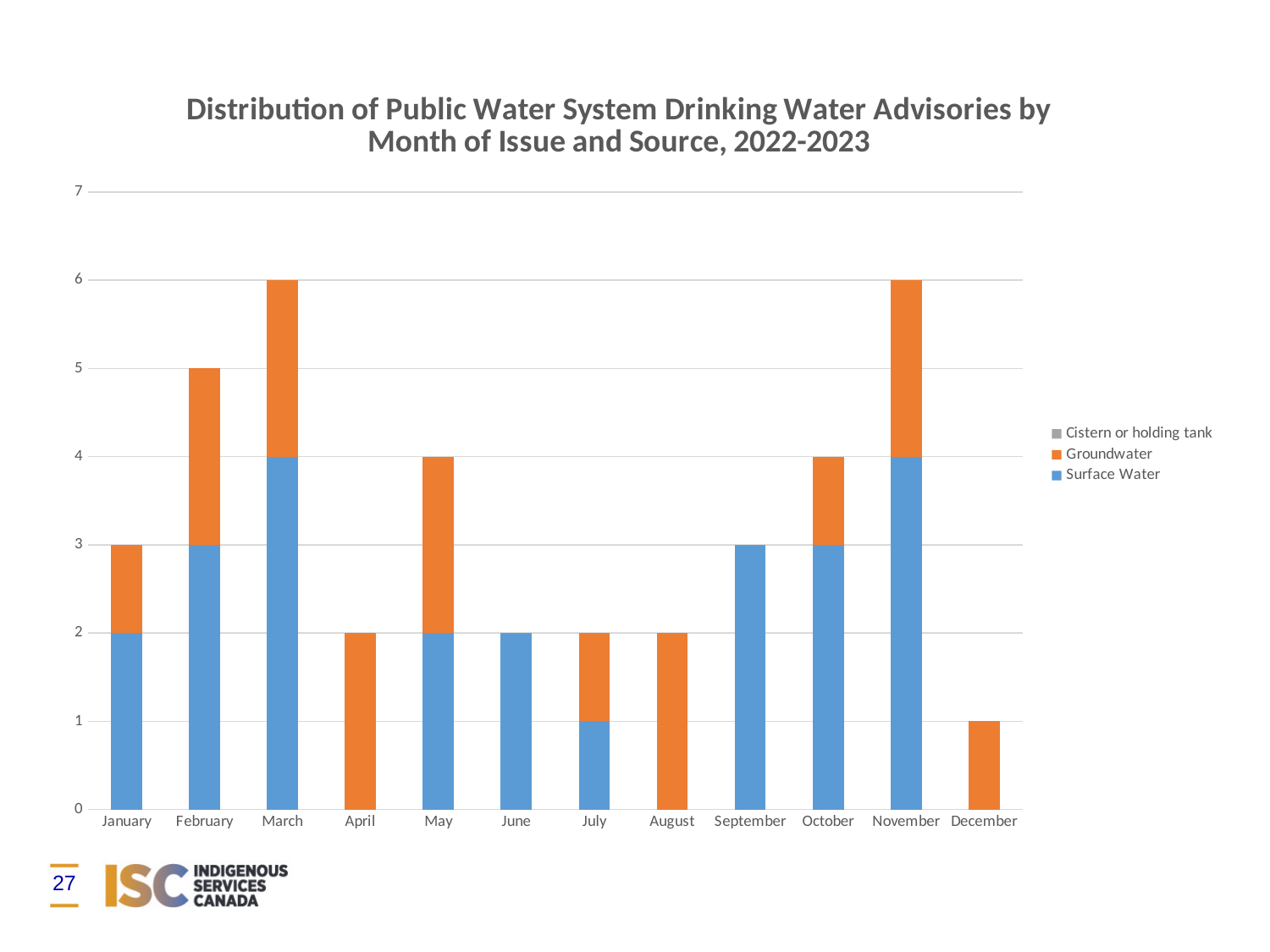
What is the Groundwater value for April? 2 Which series is shown in orange in the legend? Groundwater What is the difference between the total for March and the total for January? 3 How many months are shown on the x axis? 12 Which month has a larger total, February or October? February What kind of chart is shown on the slide? Stacked bar chart Which month has the lowest total number of advisories? December Is the total value for November greater or less than 5? greater What is the Surface Water value for January? 2 What is the Surface Water value for November? 4 What is the total height of the stacked bar for February? 5 How many series does the legend list? 3